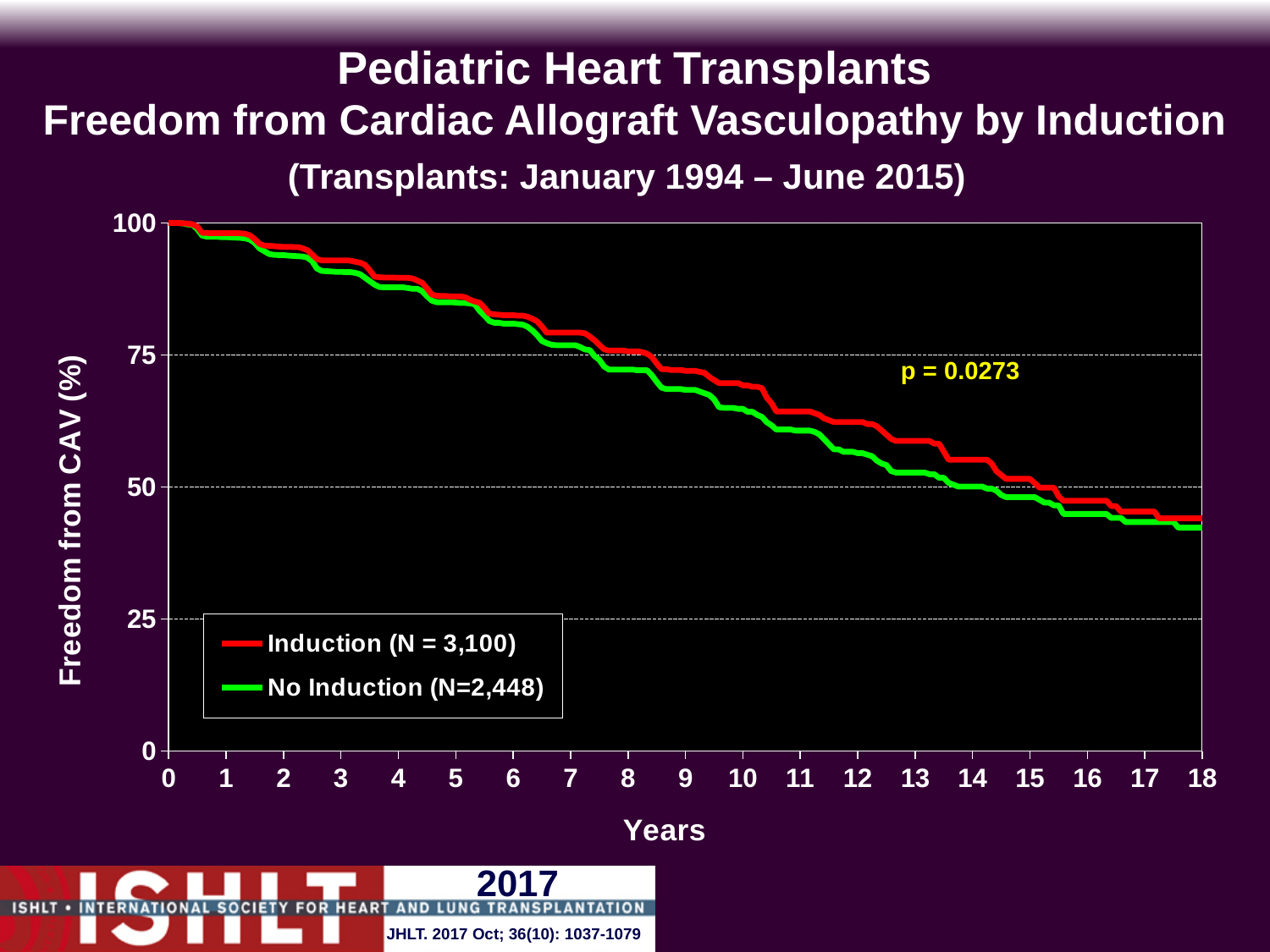
At 10 years, which group has the higher freedom from CAV, Induction or No Induction? Induction At 12 years, which curve is lower, Induction or No Induction? No Induction What kind of chart is shown on the slide? line chart Is the freedom from CAV for the Induction group at 18 years greater or less than 50? less How many series does the legend list? 2 What p-value is shown on the chart? p = 0.0273 Is the freedom from CAV for the No Induction group at 10 years greater or less than 50? greater Is the freedom from CAV for the No Induction group at 5 years greater or less than 75? greater What is the N for the Induction group according to the legend? 3,100 Do the curves rise or fall as the years increase along the x axis? fall